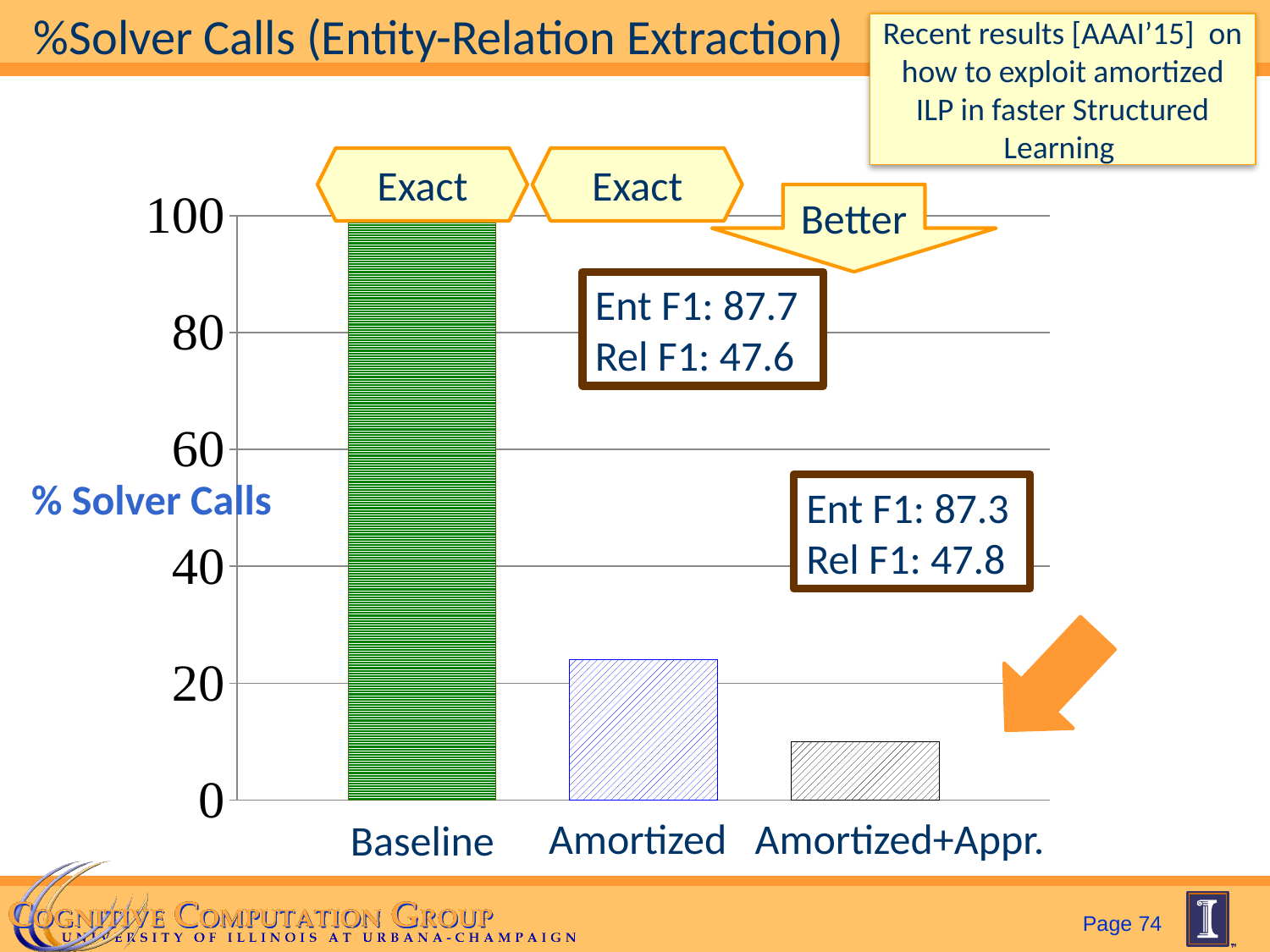
Which is larger, the value for Amortized or the value for Amortized+Appr.? Amortized What is the % Solver Calls value for Baseline? 100 What is the title of the chart on the slide? %Solver Calls (Entity-Relation Extraction) How many categories are shown on the x axis of the chart? 3 Is the value for Amortized+Appr. greater or less than 20? less Which category has the highest % Solver Calls? Baseline Which category has the lowest % Solver Calls? Amortized+Appr. What kind of chart is shown on the slide? bar chart What is the label on the y axis of the chart? % Solver Calls Is the value for Amortized greater or less than 20? greater Is the value for Amortized greater or less than 40? less Do the values rise or fall from Baseline to Amortized+Appr. along the x axis? fall